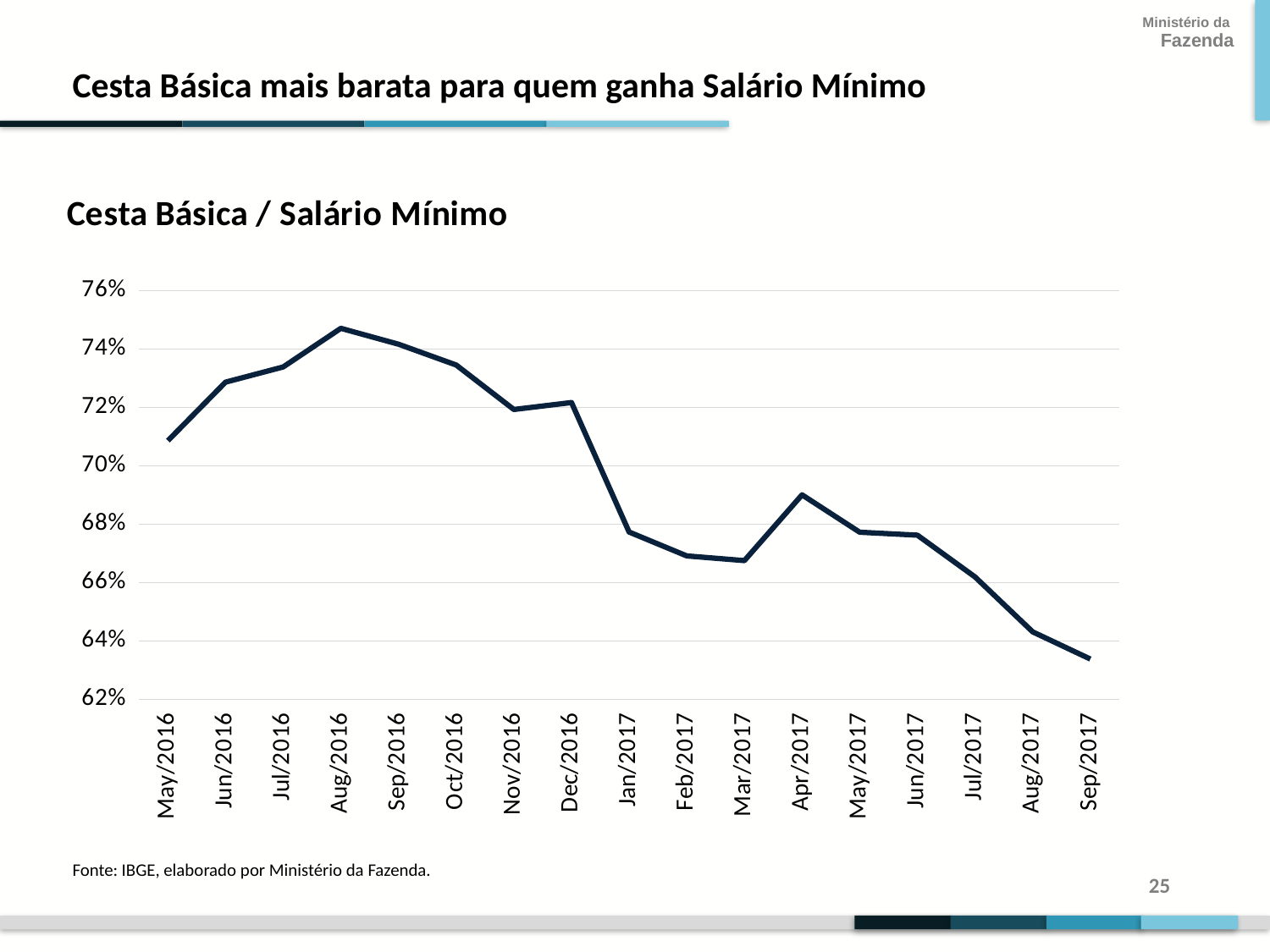
Is the value for Sep/2017 greater or less than 64%? less In which month does the line reach its lowest value? Sep/2017 In which month does the line reach its highest value? Aug/2016 Is the value for Aug/2016 greater or less than 74%? greater Is the value for Jan/2017 greater or less than 68%? less What is the title of the chart? Cesta Básica / Salário Mínimo What source is cited for the chart data? IBGE, elaborado por Ministério da Fazenda Overall, does the line rise or fall from May/2016 to Sep/2017? fall How many monthly data points are plotted on the chart? 17 Which is larger, the value for Jun/2016 or the value for Jan/2017? Jun/2016 What kind of chart is shown on the slide? line chart